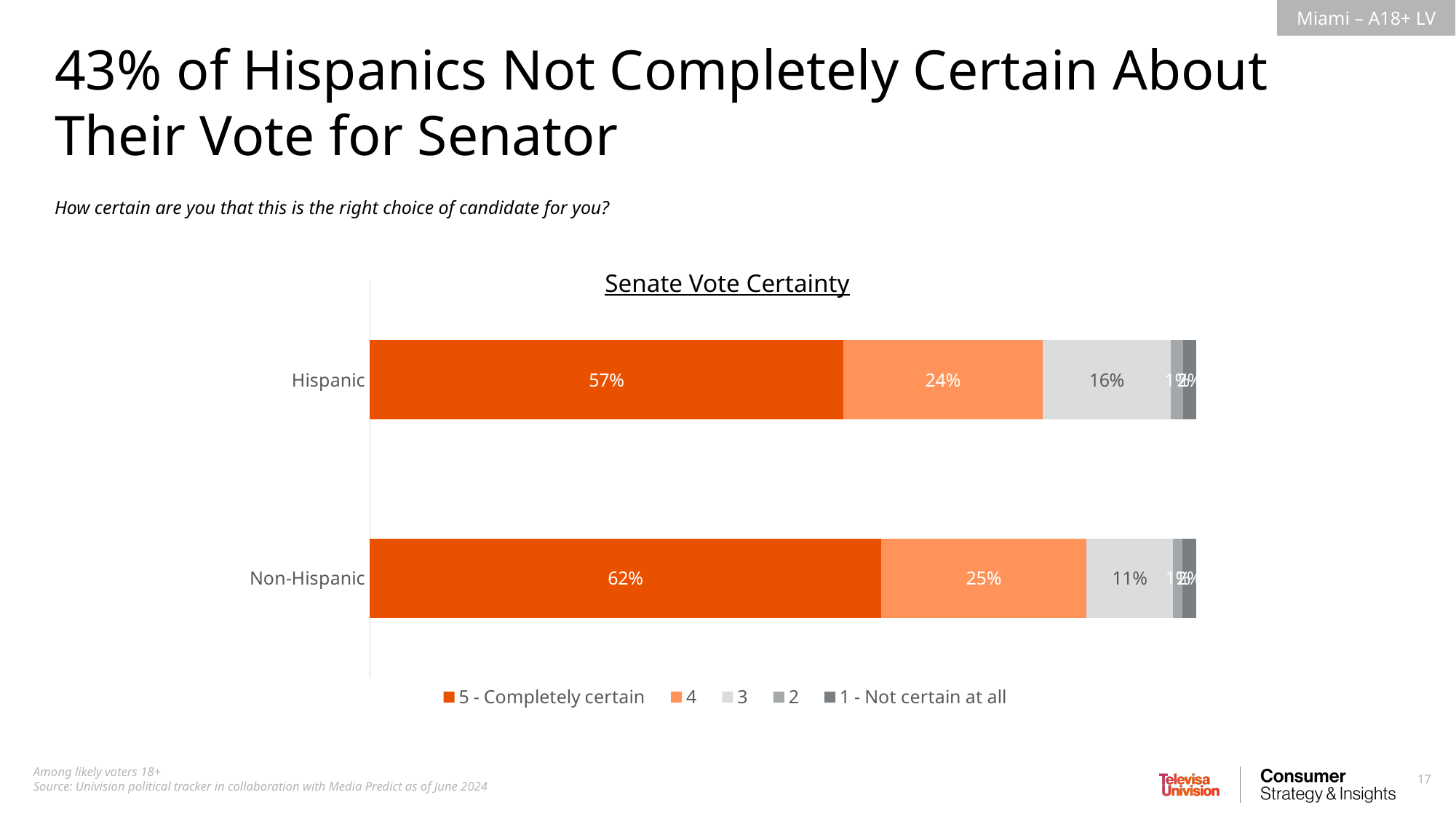
What is the value of the '3' segment for the Non-Hispanic bar? 11% What is the value of the '3' segment for the Hispanic bar? 16% What is the difference in the '3' segment between Hispanic and Non-Hispanic respondents? 5% How many series does the legend of the Senate Vote Certainty chart list? 5 What is the value of the '4' segment for the Hispanic bar? 24% What is the title of the chart on the slide? Senate Vote Certainty How many groups (categories) are shown in the Senate Vote Certainty chart? 2 What is the difference in the '5 - Completely certain' share between Non-Hispanic and Hispanic respondents? 5% Which group has the higher share of '5 - Completely certain' respondents, Hispanic or Non-Hispanic? Non-Hispanic What percentage of Non-Hispanic likely voters are '5 - Completely certain' about their Senate vote? 62% What type of chart is used to show Senate Vote Certainty? Stacked bar chart What percentage of Hispanic likely voters are '5 - Completely certain' about their Senate vote? 57%